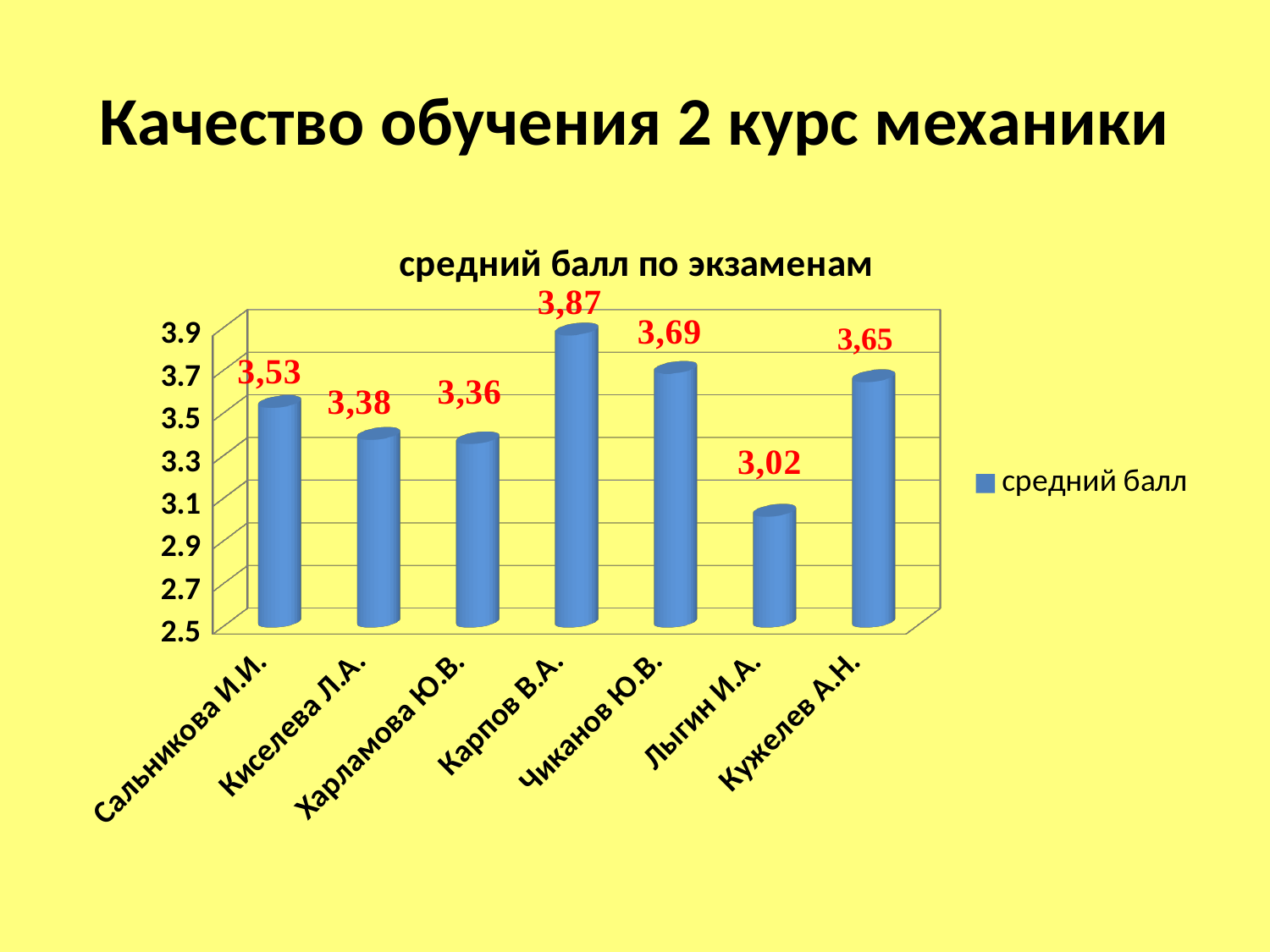
Is the value for Харламова Ю.В. greater or less than 3.5? less What type of chart is shown on the slide? bar chart What is the average exam score for Карпов В.А.? 3,87 What is the average exam score for Сальникова И.И.? 3,53 What is the average exam score for Лыгин И.А.? 3,02 Who has the higher average score, Чиканов Ю.В. or Кужелев А.Н.? Чиканов Ю.В. What is the difference between the average scores of Сальникова И.И. and Киселева Л.А.? 0,15 What is the difference between the average scores of Карпов В.А. and Лыгин И.А.? 0,85 Which student has the highest average exam score? Карпов В.А. What is the title of the chart? средний балл по экзаменам Which student has the lowest average exam score? Лыгин И.А. How many students are shown on the chart? 7